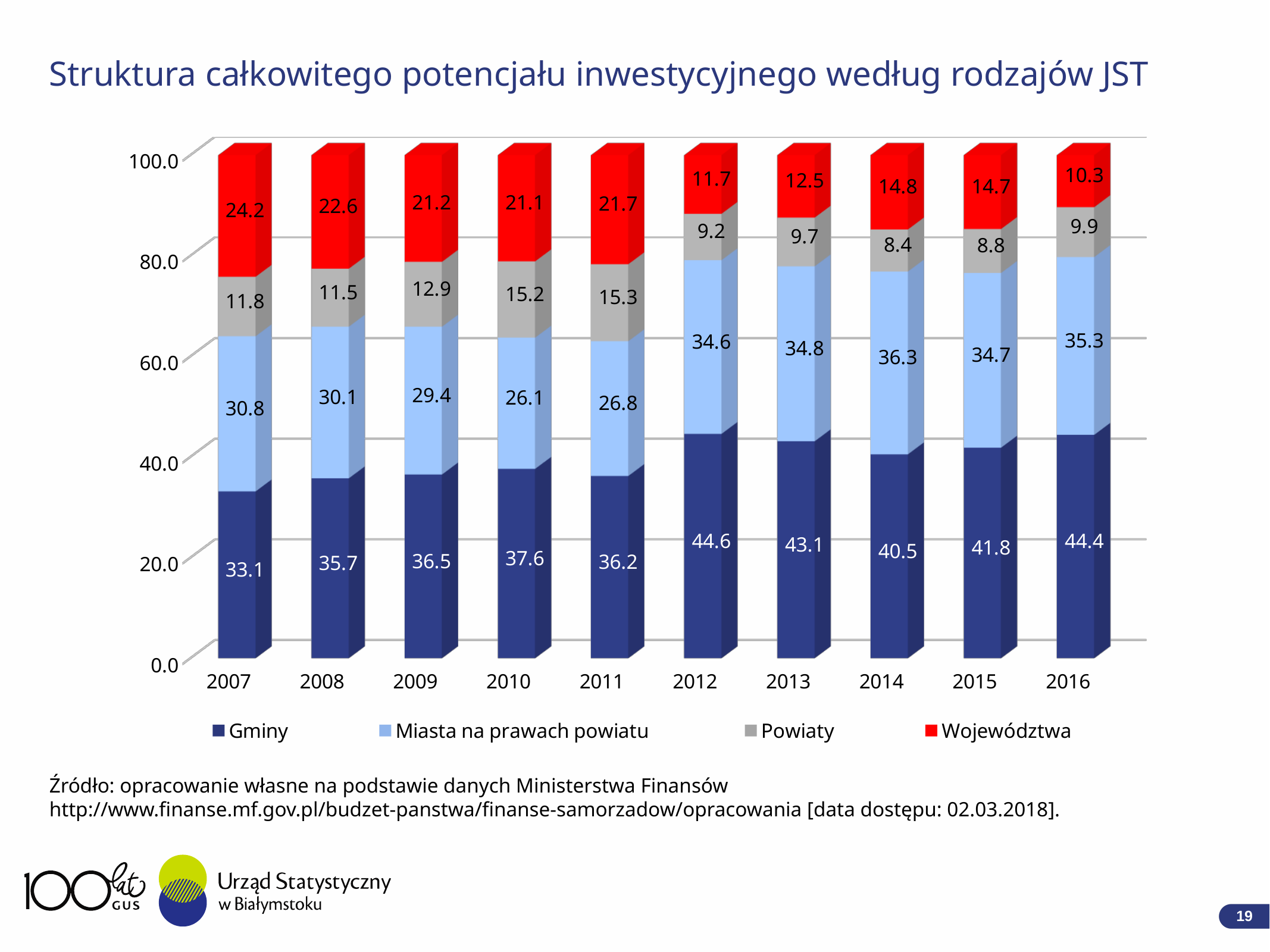
How many series does the legend list? 4 In which year is the Województwa value lowest? 2016 What is the total of the stacked bar for 2007? 99.9 What is the value for Powiaty in 2011? 15.3 What is the value for Gminy in 2012? 44.6 How many years are shown on the x axis? 10 What is the value for Województwa in 2007? 24.2 In which year is the Gminy value highest? 2012 What kind of chart is shown on the slide? Stacked bar chart What is the difference between the Województwa value in 2007 and in 2016? 13.9 What is the value for Miasta na prawach powiatu in 2014? 36.3 Which is larger, the Powiaty value in 2010 or in 2012? 2010